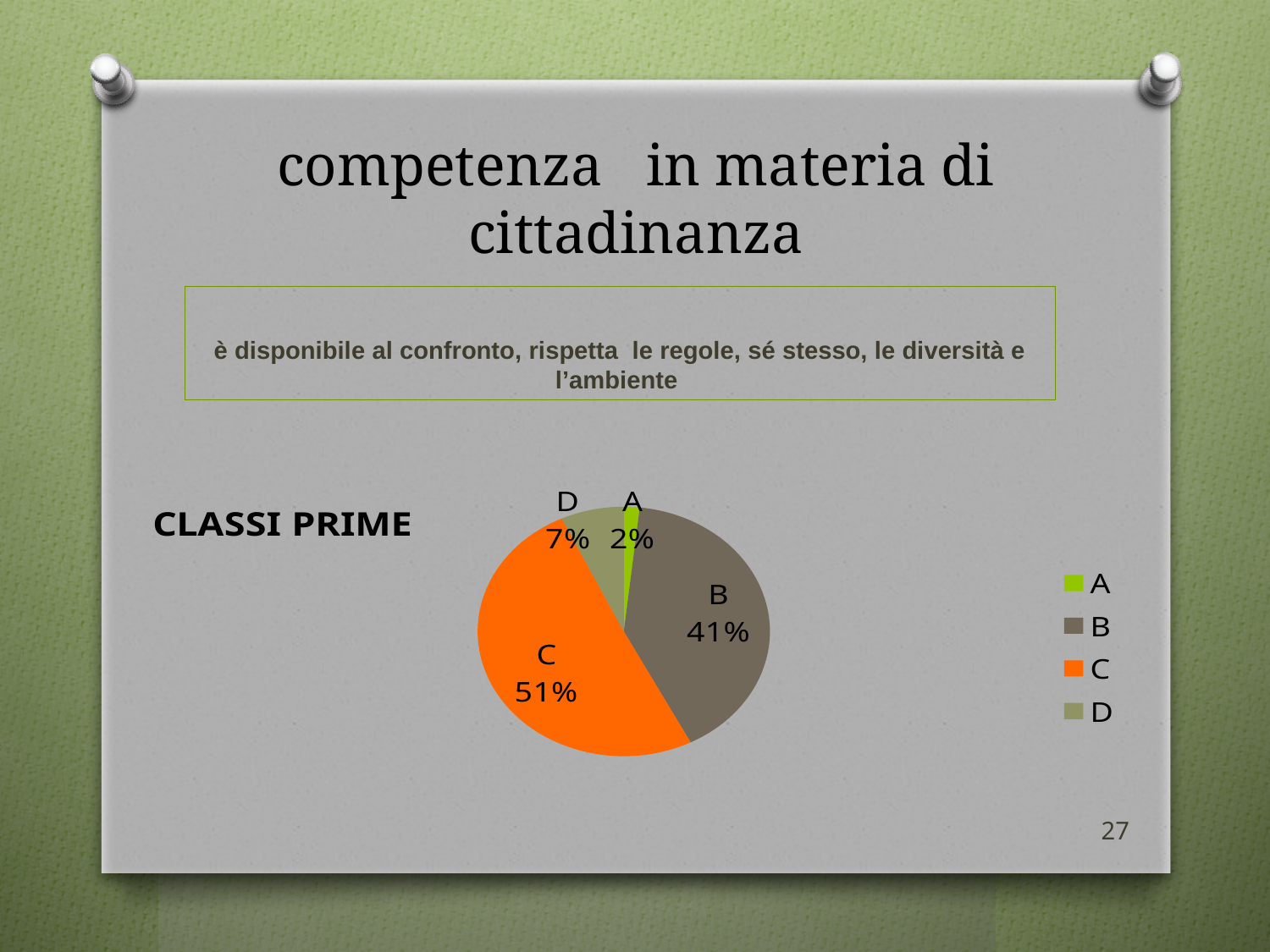
What kind of chart is shown on the slide? pie chart How many slices does the pie chart have? 4 Which category has the smallest slice of the pie? A What share of the pie does category D have? 7% What share of the pie does category A have? 2% What is the difference in percentage points between category C and category B? 10% Which category has the largest slice of the pie? C What share of the pie does category C have? 51% Which is larger, the slice for B or the slice for D? B How many entries does the legend list? 4 What colour is the slice for category C? orange